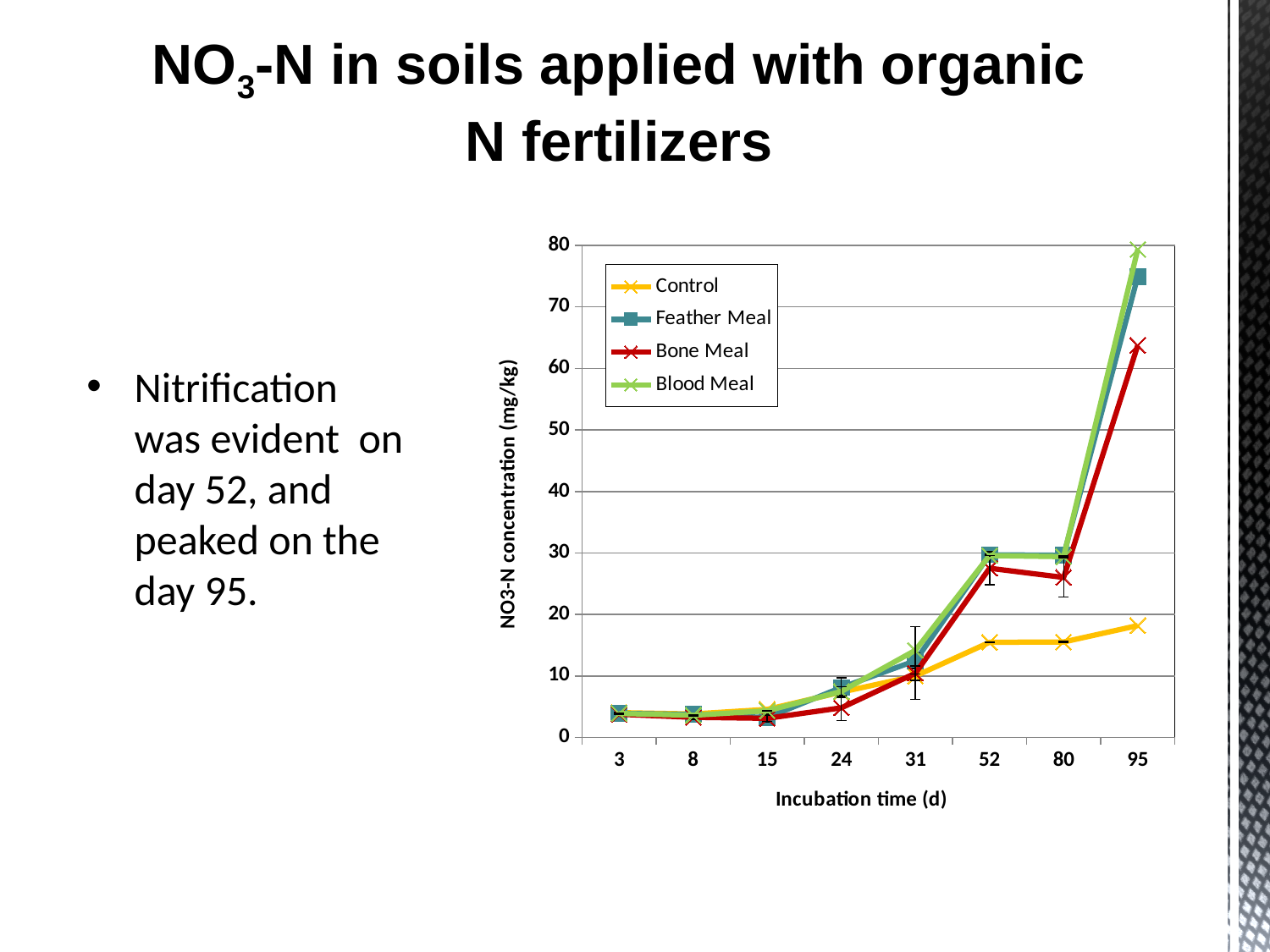
What kind of chart is shown on the slide? line chart Is the value for Blood Meal at day 95 greater or less than 70? greater How many incubation time points are plotted along the x axis? 8 What is the title of the x axis? Incubation time (d) At day 80, which is larger: Control or Bone Meal? Bone Meal Does the Control series rise or fall from day 3 to day 95? rise Is the value for Bone Meal at day 95 greater or less than 70? less How many series does the legend list? 4 Which series has the lowest value at day 95? Control At day 95, which is larger: Blood Meal or Bone Meal? Blood Meal Is the value for Control at day 95 greater or less than 20? less